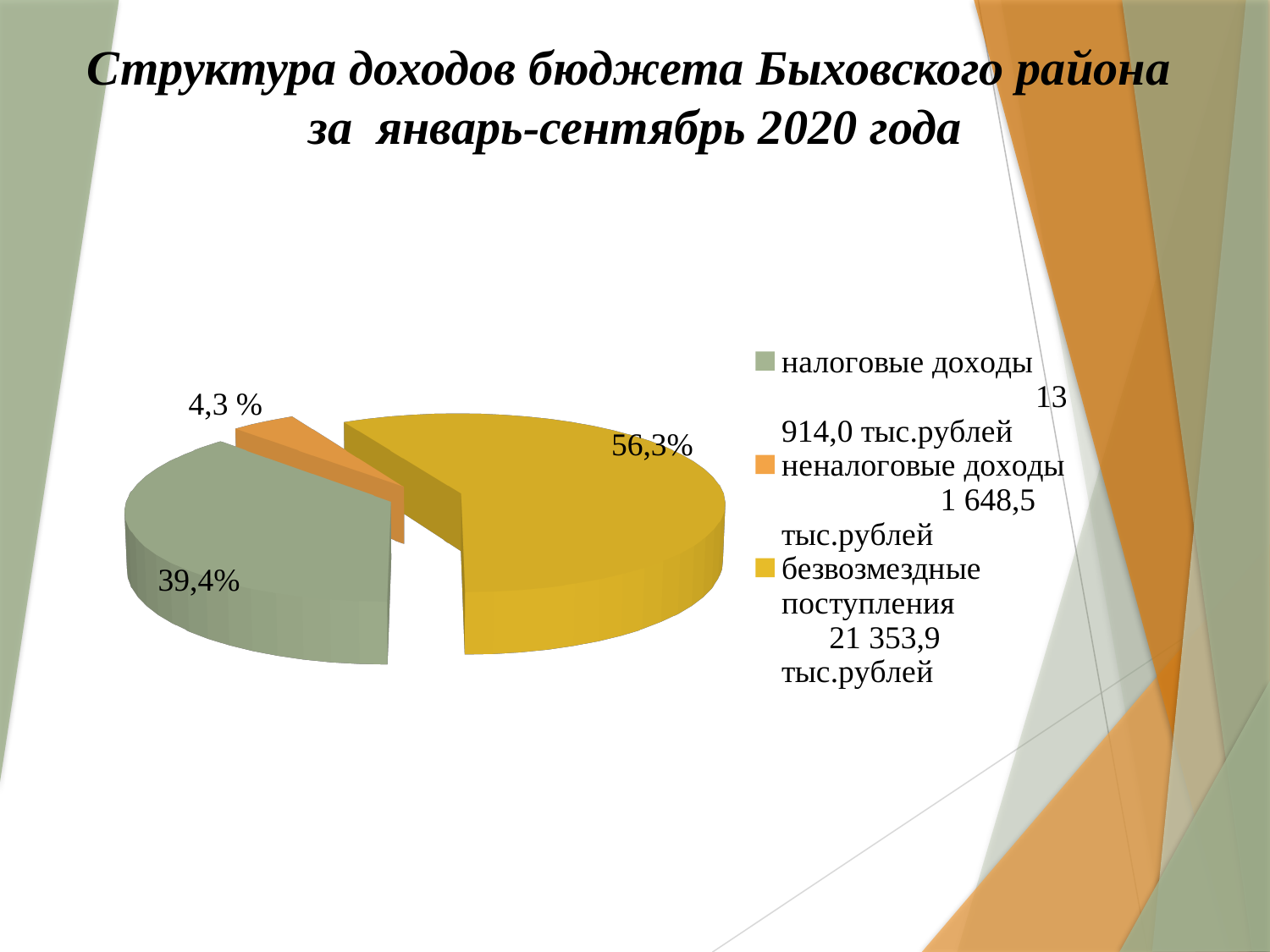
Which is larger, the share of налоговые доходы or the share of неналоговые доходы? налоговые доходы What colour is the slice for неналоговые доходы? orange How many entries does the legend list? 3 Which category has the largest share of the pie? безвозмездные поступления What kind of chart is shown on the slide? pie chart What amount in тыс.рублей does the legend give for налоговые доходы? 13 914,0 тыс.рублей How many slices does the pie chart have? 3 Which category has the smallest share of the pie? неналоговые доходы What amount in тыс.рублей does the legend give for безвозмездные поступления? 21 353,9 тыс.рублей What percentage share is shown for налоговые доходы? 39,4% What percentage share is shown for безвозмездные поступления? 56,3% What percentage share is shown for неналоговые доходы? 4,3 %